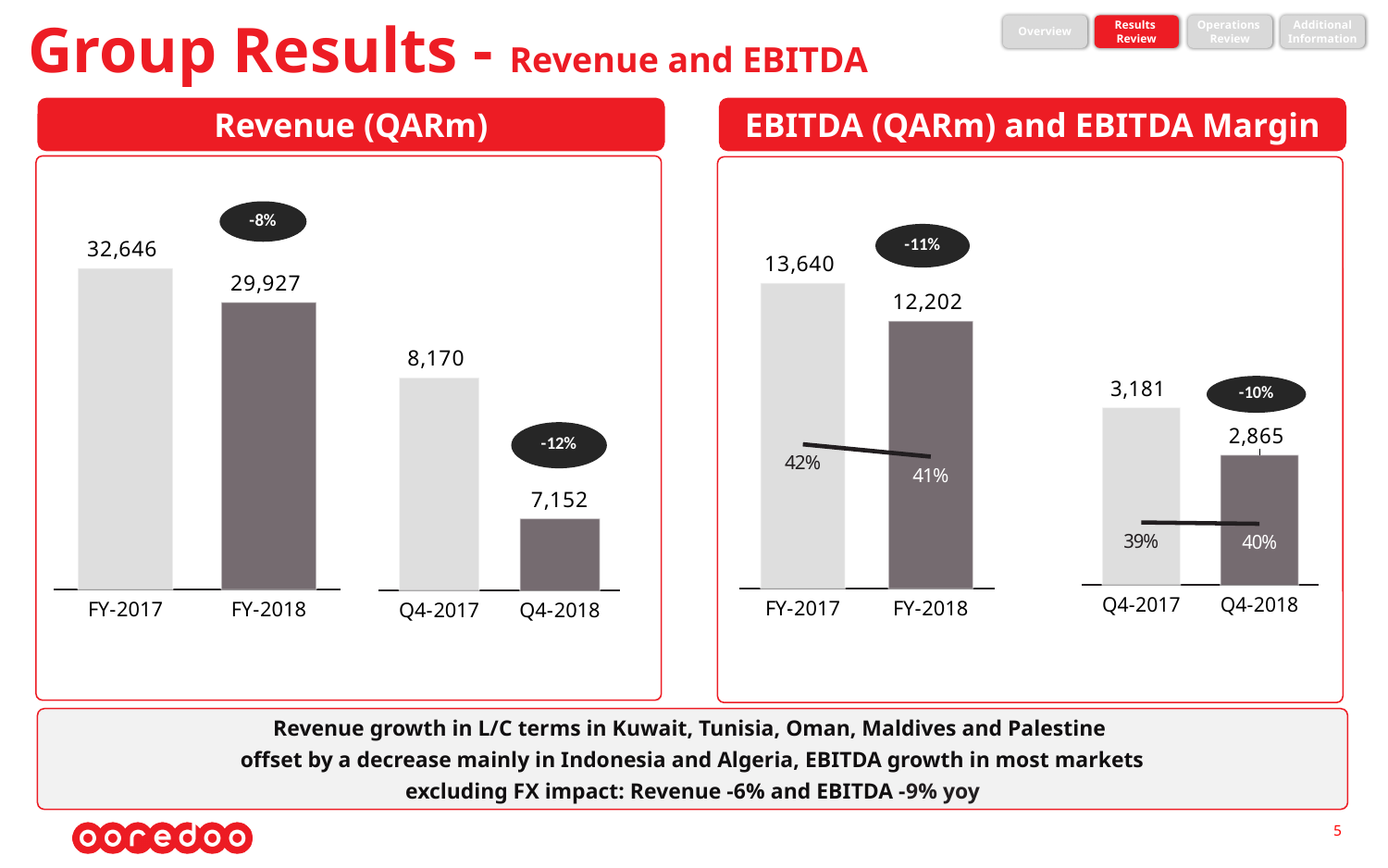
In the EBITDA (QARm) and EBITDA Margin chart, what is the difference between Q4-2017 and Q4-2018 EBITDA? 316 In the Revenue (QARm) chart, what is the difference between FY-2017 and FY-2018 revenue? 2,719 In the Revenue (QARm) chart, which category has the lowest value? Q4-2018 In the EBITDA (QARm) and EBITDA Margin chart, what is the EBITDA for FY-2017? 13,640 In the Revenue (QARm) chart, what is the revenue for FY-2018? 29,927 In the EBITDA (QARm) and EBITDA Margin chart, what is the EBITDA margin for Q4-2018? 40% In the Revenue (QARm) chart, what percentage change is shown between Q4-2017 and Q4-2018? -12% In the EBITDA (QARm) and EBITDA Margin chart, what percentage change is shown between FY-2017 and FY-2018? -11% In the Revenue (QARm) chart, what is the revenue for Q4-2017? 8,170 How many bars are plotted in the Revenue (QARm) chart? 4 In the EBITDA (QARm) and EBITDA Margin chart, which is larger, the EBITDA margin for FY-2017 or FY-2018? FY-2017 What type of chart is the Revenue (QARm) chart? Bar chart